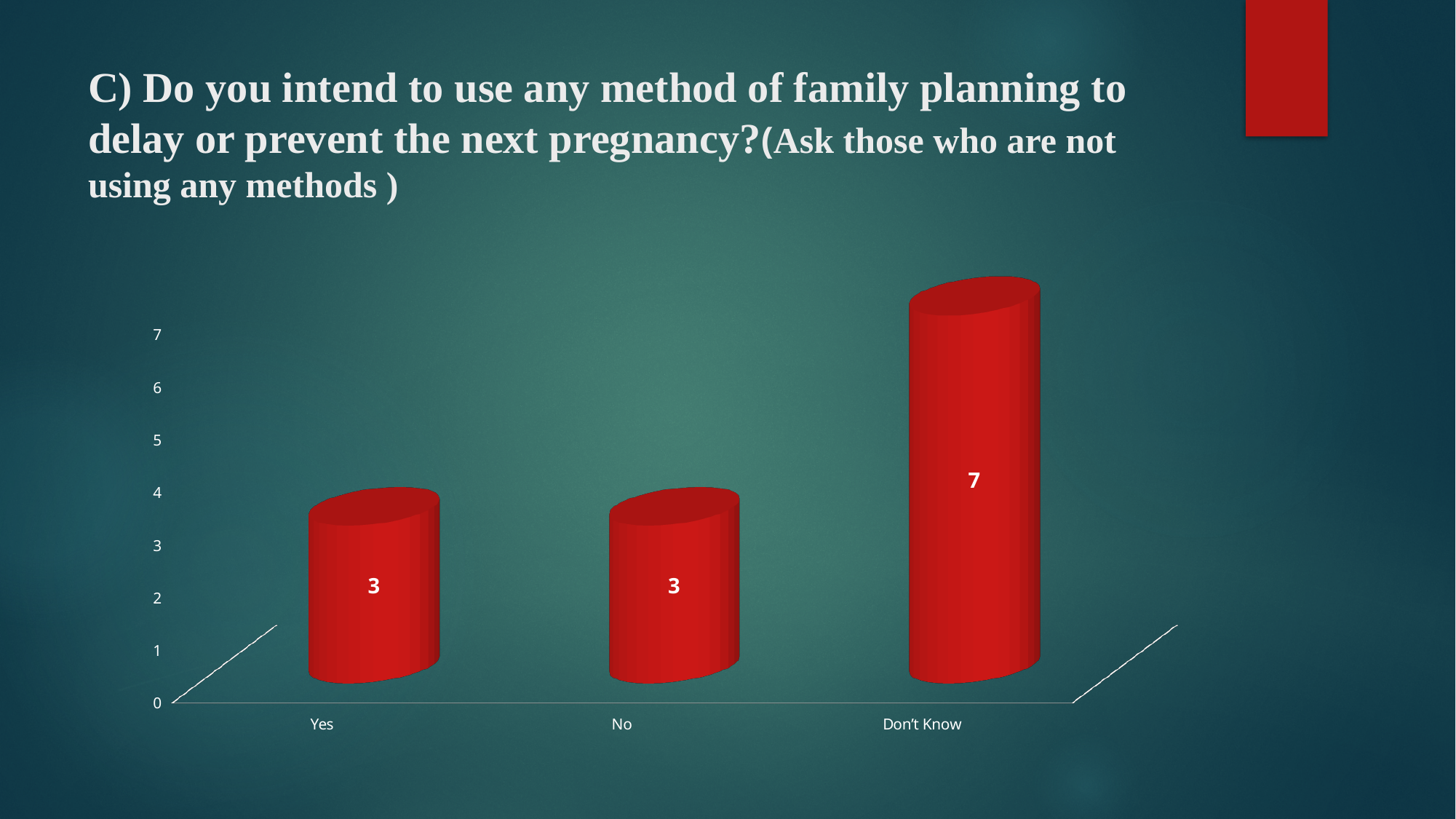
What colour are the bars in the chart? Red What is the value for "Yes"? 3 How many categories are shown on the x axis? 3 What is the difference between the values for "Don't Know" and "Yes"? 4 Which category has the highest value? Don't Know Is the value for "Yes" greater or less than 5? less Is the value for "Don't Know" greater or less than 5? greater What is the total of all three bar values? 13 What is the value for "No"? 3 Is the value for "Don't Know" larger than the value for "No"? Yes What is the value for "Don't Know"? 7 What kind of chart is shown on the slide? Bar chart